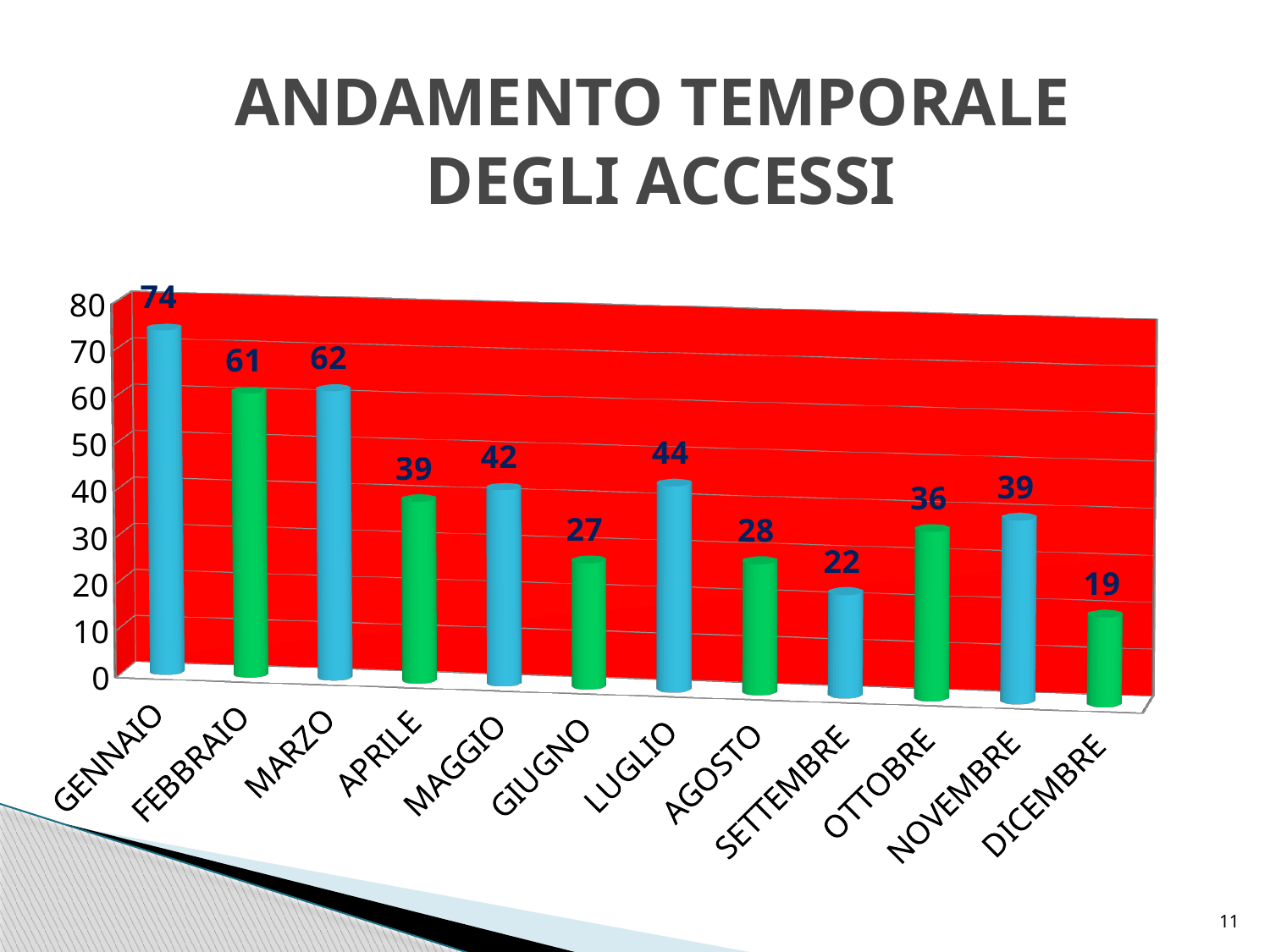
What is the difference between the values for MARZO and FEBBRAIO? 1 Is the value for OTTOBRE greater or less than 30? greater What is the title of the chart? ANDAMENTO TEMPORALE DEGLI ACCESSI What kind of chart is shown on the slide? bar chart Which month has the lowest value? DICEMBRE What is the difference between the values for GENNAIO and DICEMBRE? 55 How many months are shown on the x axis? 12 Which is larger, the value for MAGGIO or the value for GIUGNO? MAGGIO What is the value for GENNAIO? 74 Which month has the highest value? GENNAIO What is the value for SETTEMBRE? 22 What is the value for LUGLIO? 44